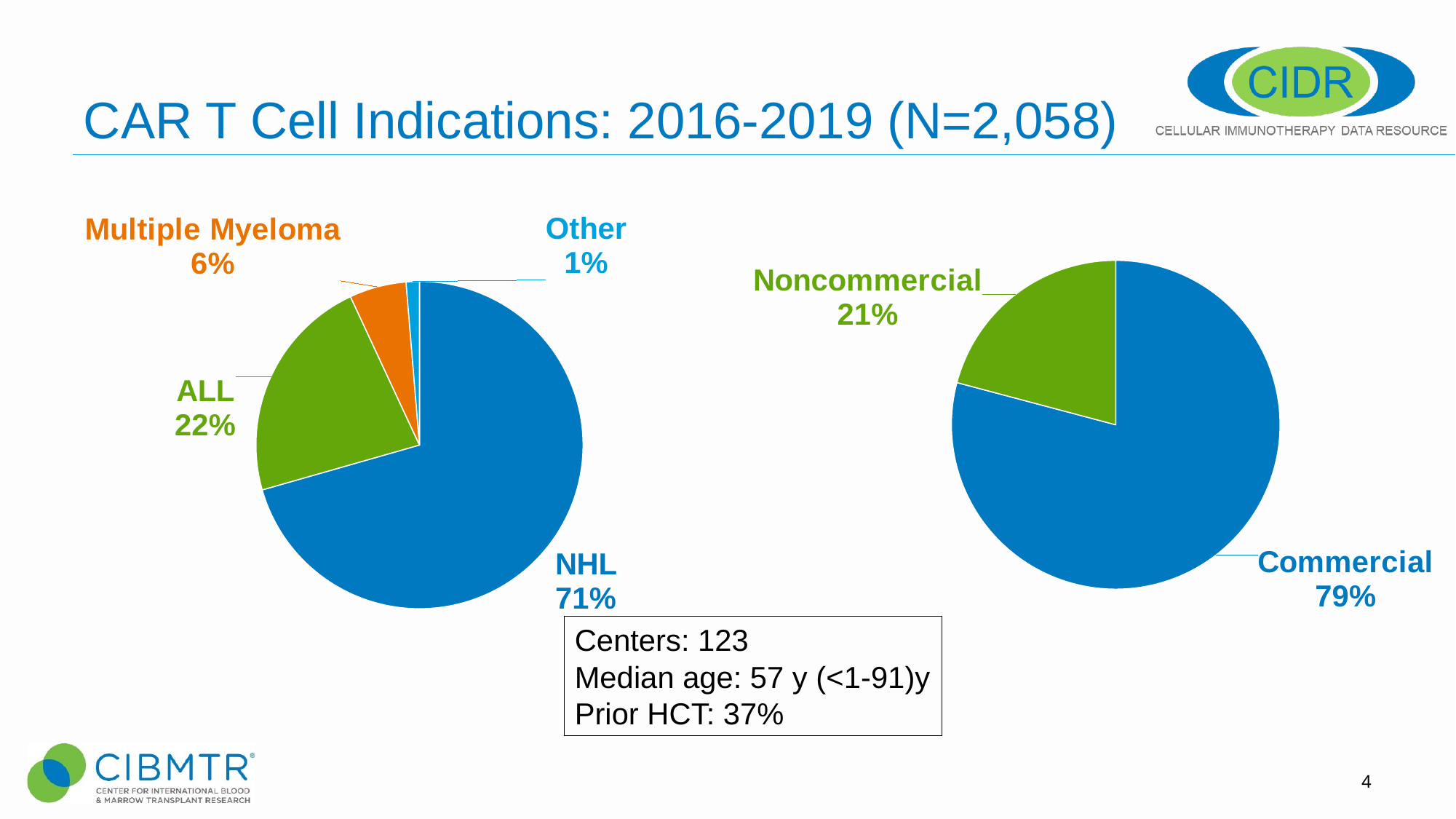
In the left pie chart, what share does Multiple Myeloma have? 6% What type of chart is shown on the right side of the slide? Pie chart In the left pie chart, what share does ALL have? 22% In the right pie chart, what share is Commercial? 79% In the right pie chart, which is larger, Commercial or Noncommercial? Commercial In the left pie chart, what share does Other have? 1% In the left pie chart, which category has the largest slice? NHL In the left pie chart, which category has the smallest slice? Other In the left pie chart, what is the difference in percentage points between NHL and ALL? 49 In the right pie chart, what share is Noncommercial? 21% How many slices does the left pie chart have? 4 In the left pie chart, what share does NHL have? 71%